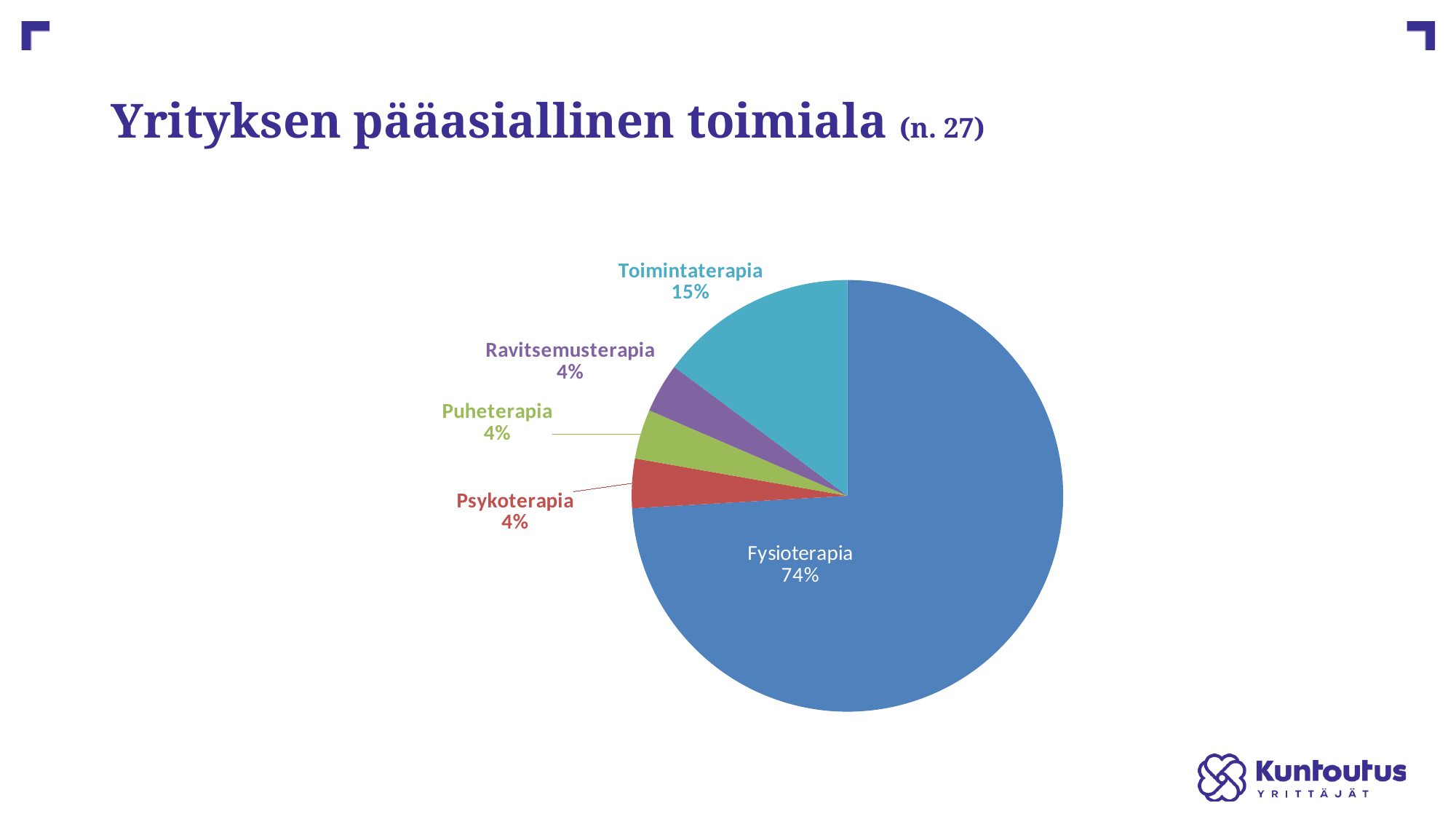
What share of the pie does Fysioterapia have? 74% How many slices does the pie chart have? 5 What is the title of the slide containing the chart? Yrityksen pääasiallinen toimiala (n. 27) What colour is the Fysioterapia slice? blue Which is larger, the share for Toimintaterapia or the share for Puheterapia? Toimintaterapia What kind of chart is shown on the slide? pie chart What is the value shown for Psykoterapia? 4% What is the value shown for Ravitsemusterapia? 4% What is the difference between the shares of Fysioterapia and Toimintaterapia? 59 percentage points What is the difference between the shares of Toimintaterapia and Psykoterapia? 11 percentage points Which category has the largest slice of the pie? Fysioterapia What share of the pie does Toimintaterapia have? 15%